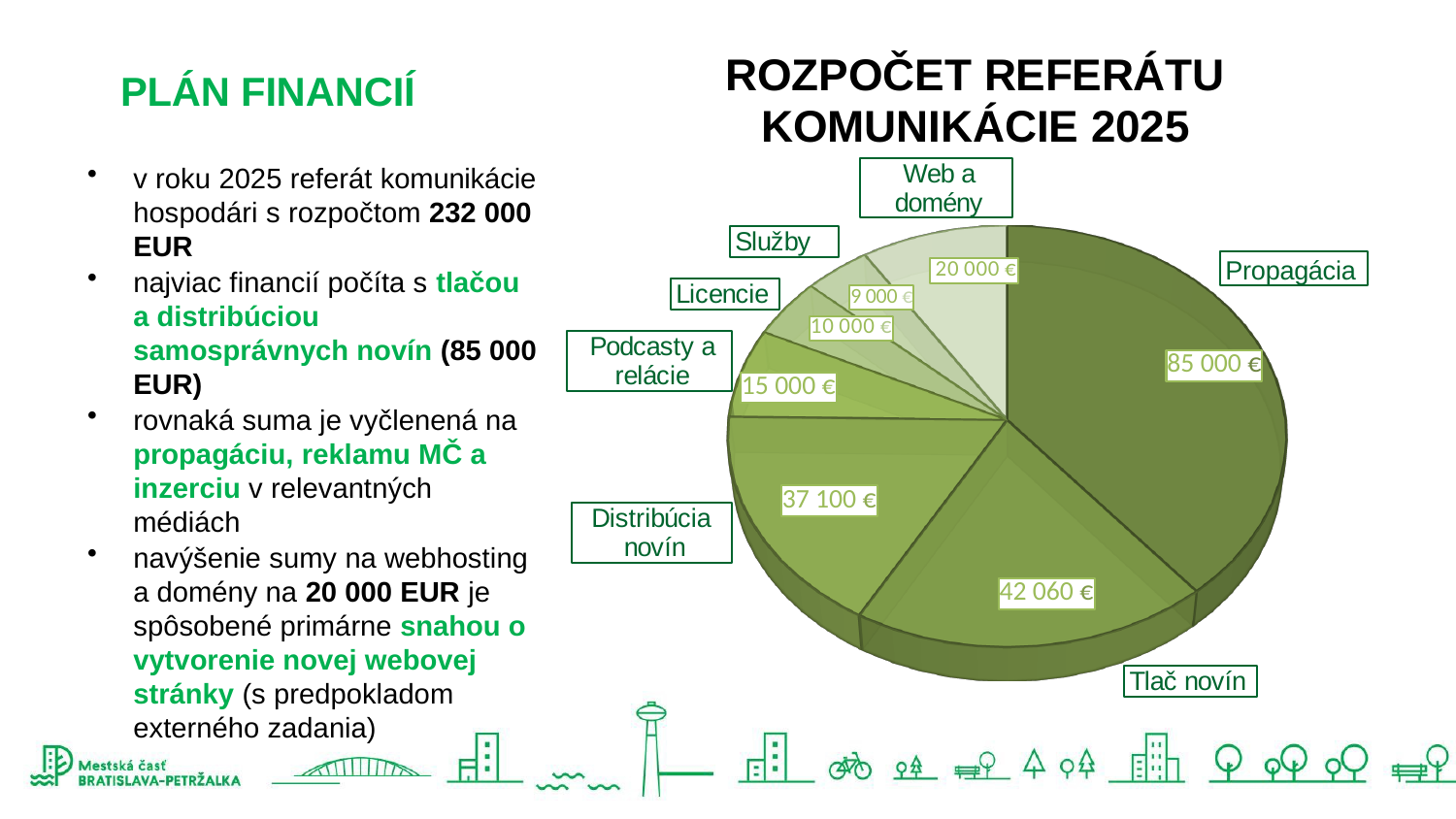
How many slices does the pie chart have? 7 What is the value for Distribúcia novín? 37 100 € What is the title of the chart? ROZPOČET REFERÁTU KOMUNIKÁCIE 2025 What is the value for Licencie? 10 000 € What is the difference between Propagácia and Tlač novín? 42 940 € What is the value for Tlač novín? 42 060 € Which category has the smallest slice? Služby Which category has the largest slice? Propagácia What is the value for Propagácia? 85 000 € Which is larger, Tlač novín or Distribúcia novín? Tlač novín What kind of chart is shown on the slide? pie chart What is the value for Web a domény? 20 000 €